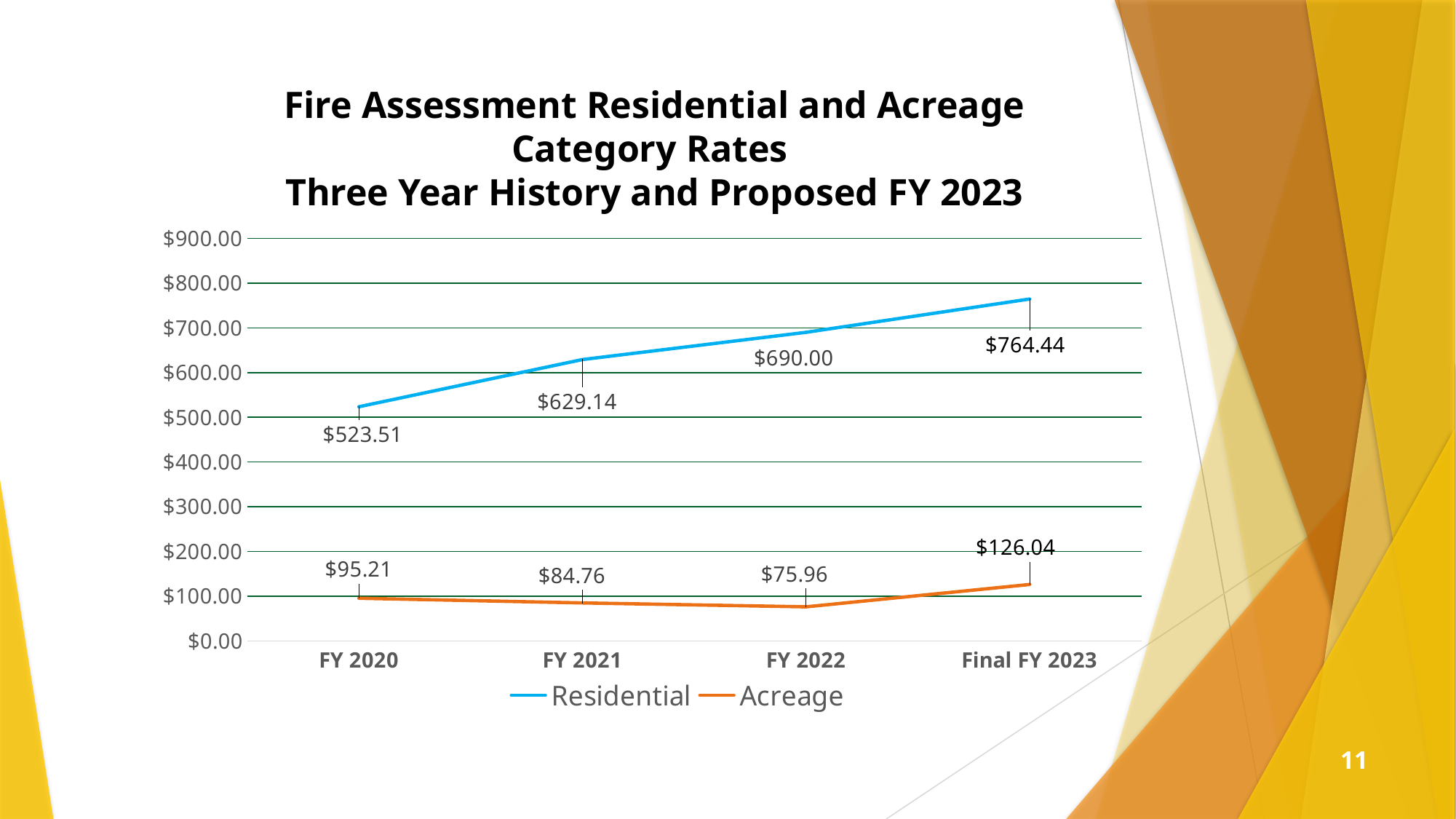
What is the Acreage rate for Final FY 2023? $126.04 Does the Residential rate rise or fall from FY 2020 to Final FY 2023? Rise What is the Residential rate for FY 2021? $629.14 How many fiscal years are shown on the x axis? 4 How many series does the legend list? 2 What kind of chart is shown on the slide? Line chart In which year is the Residential rate highest? Final FY 2023 What is the Acreage rate for FY 2022? $75.96 What is the difference between the Residential rate in Final FY 2023 and in FY 2022? $74.44 Which is larger, the Acreage rate in FY 2020 or in FY 2021? FY 2020 In which year is the Acreage rate lowest? FY 2022 What is the Residential rate for FY 2020? $523.51